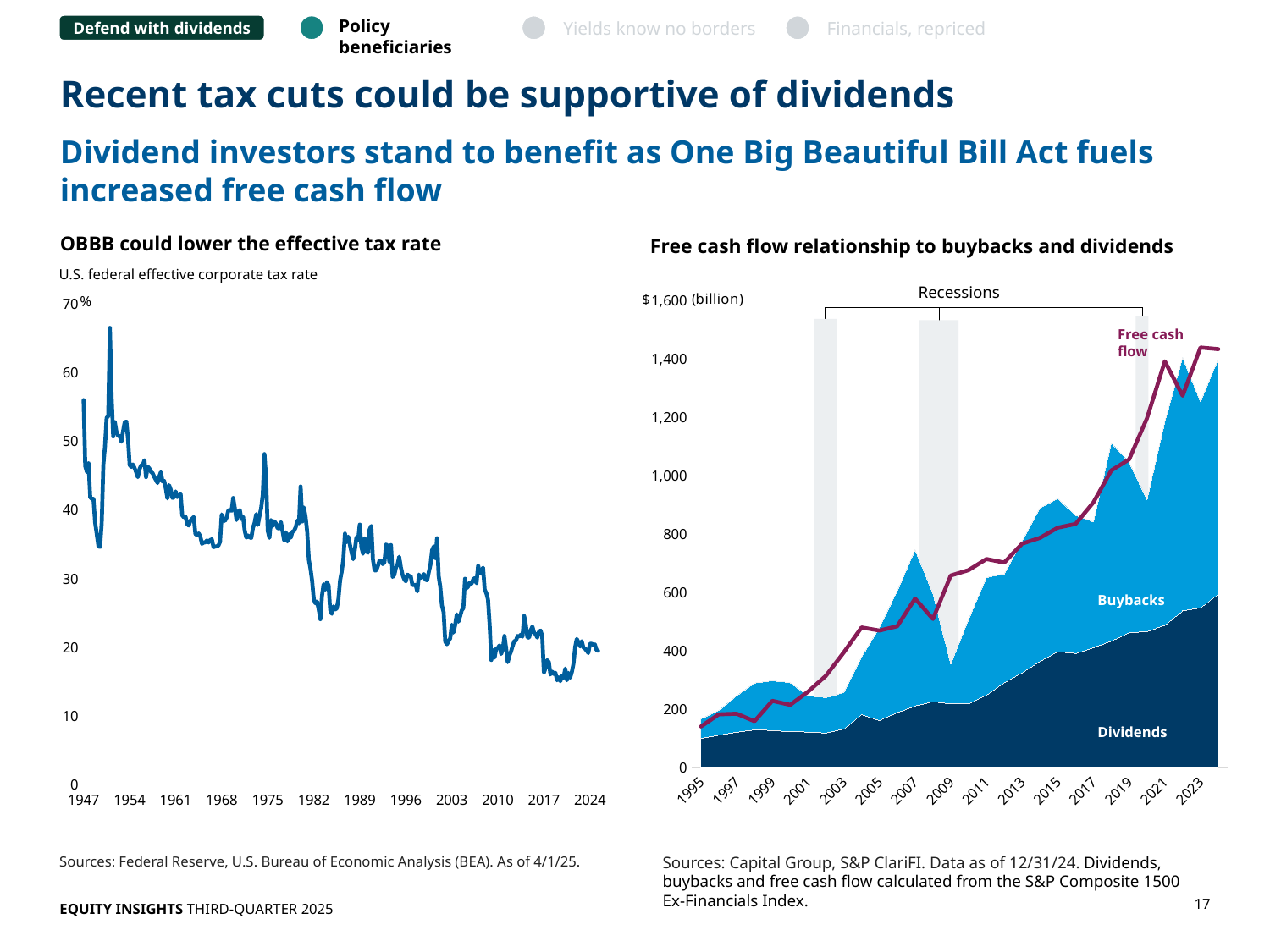
What kind of chart is the left chart, 'OBBB could lower the effective tax rate'? Line chart In the right chart, is free cash flow in 1995 greater or less than $200 billion? less In the left chart, does the U.S. federal effective corporate tax rate generally rise or fall from 1947 to 2024? Fall How many data series are shown in the right chart, 'Free cash flow relationship to buybacks and dividends'? 3 In the left chart, is the effective corporate tax rate in 2024 greater or less than 30%? less In the right chart, what do the grey shaded vertical bands represent? Recessions In the right chart, is free cash flow in 2021 greater or less than $1,200 billion? greater In the right chart, which is larger in 2023, the Dividends layer or the Buybacks layer? Buybacks What kind of chart is the right chart, 'Free cash flow relationship to buybacks and dividends'? Combination area and line chart In the right chart, does free cash flow generally rise or fall from 1995 to 2023? Rise